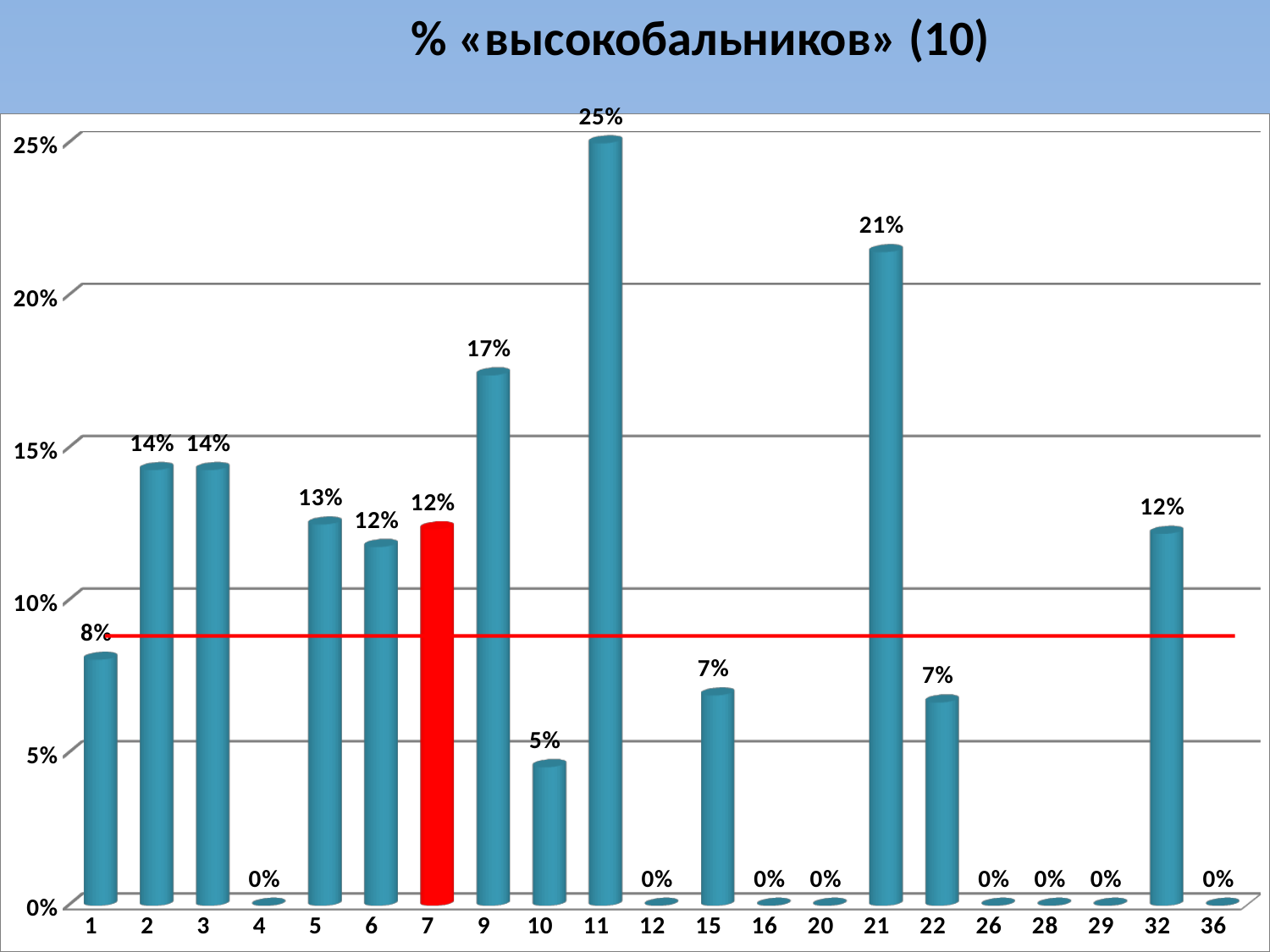
What is the difference between the values for category 11 and category 21? 4% What is the value for category 10? 5% Which is larger, the value for category 5 or the value for category 15? 5 Which category's bar is coloured red? 7 What is the difference between the values for category 9 and category 1? 9% What is the value for category 11? 25% What is the value for category 7, the red bar? 12% What kind of chart is shown on the slide? bar chart How many categories are shown on the x axis? 21 What is the value for category 21? 21% What is the title of the chart? % «высокобальников» (10) Which category has the highest value? 11